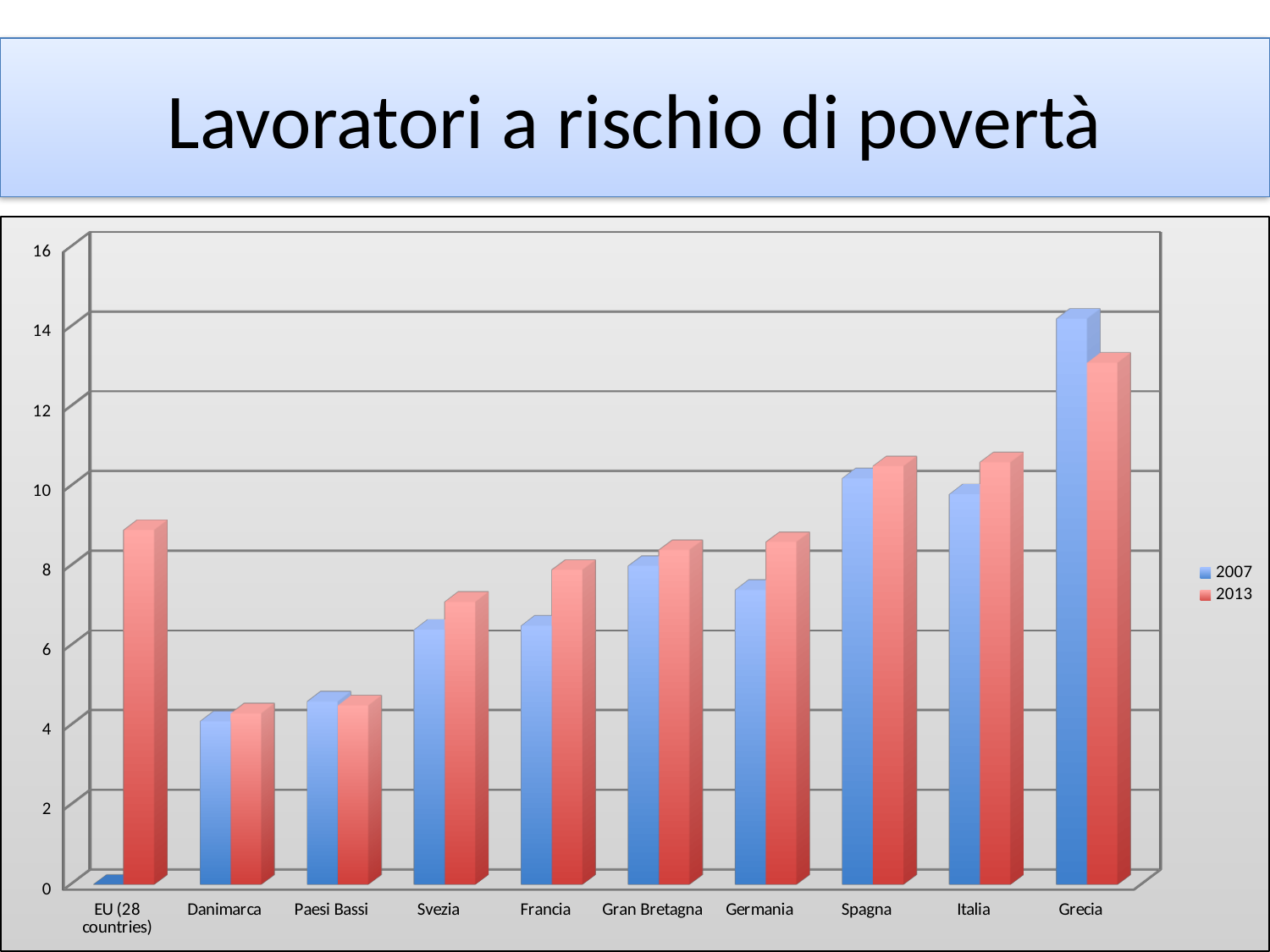
How many series does the legend list? 2 Is the 2013 value for EU (28 countries) greater or less than 8? greater Which is larger: the 2013 value for Francia or the 2013 value for Svezia? Francia How many countries/categories are shown on the x axis? 10 What kind of chart is shown on the slide? bar chart Which category has the highest value for 2013? Grecia For Grecia, which is larger: the 2007 value or the 2013 value? 2007 Is the 2013 value for Italia greater or less than 10? greater Which category has the highest value for 2007? Grecia Is the 2013 value for Grecia greater or less than 12? greater What is the title of the slide containing the chart? Lavoratori a rischio di povertà